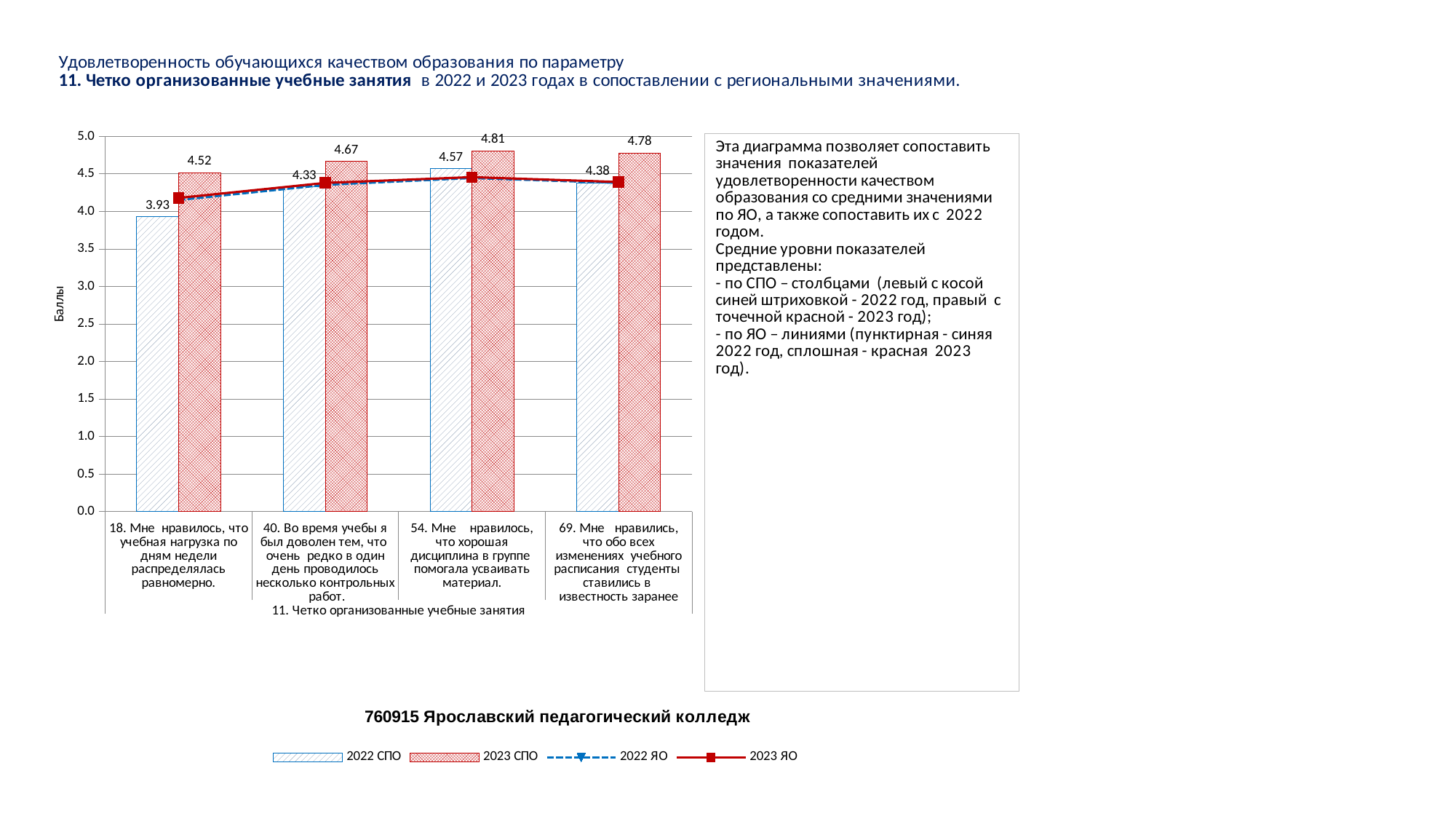
What is the difference between the 2023 СПО and 2022 СПО values for category 40? 0.34 What is the difference between the 2023 СПО and 2022 СПО values for category 18? 0.59 Which category has the highest 2023 СПО value? 54. Мне нравилось, что хорошая дисциплина в группе помогала усваивать материал. What is the 2022 СПО value for category 18 ("Мне нравилось, что учебная нагрузка по дням недели распределялась равномерно")? 3.93 What is the 2023 СПО value for category 54 ("Мне нравилось, что хорошая дисциплина в группе помогала усваивать материал")? 4.81 Is the 2023 ЯО value for category 18 greater or less than 4.5? less How many categories are shown on the x axis of the chart? 4 What is the label of the vertical axis of the chart? Баллы What is the 2023 СПО value for category 69 ("Мне нравились, что обо всех изменениях учебного расписания студенты ставились в известность заранее")? 4.78 Which category has the lowest 2022 СПО value? 18. Мне нравилось, что учебная нагрузка по дням недели распределялась равномерно. How many series does the chart legend list? 4 Which is larger for category 69: the 2022 СПО value or the 2023 СПО value? 2023 СПО